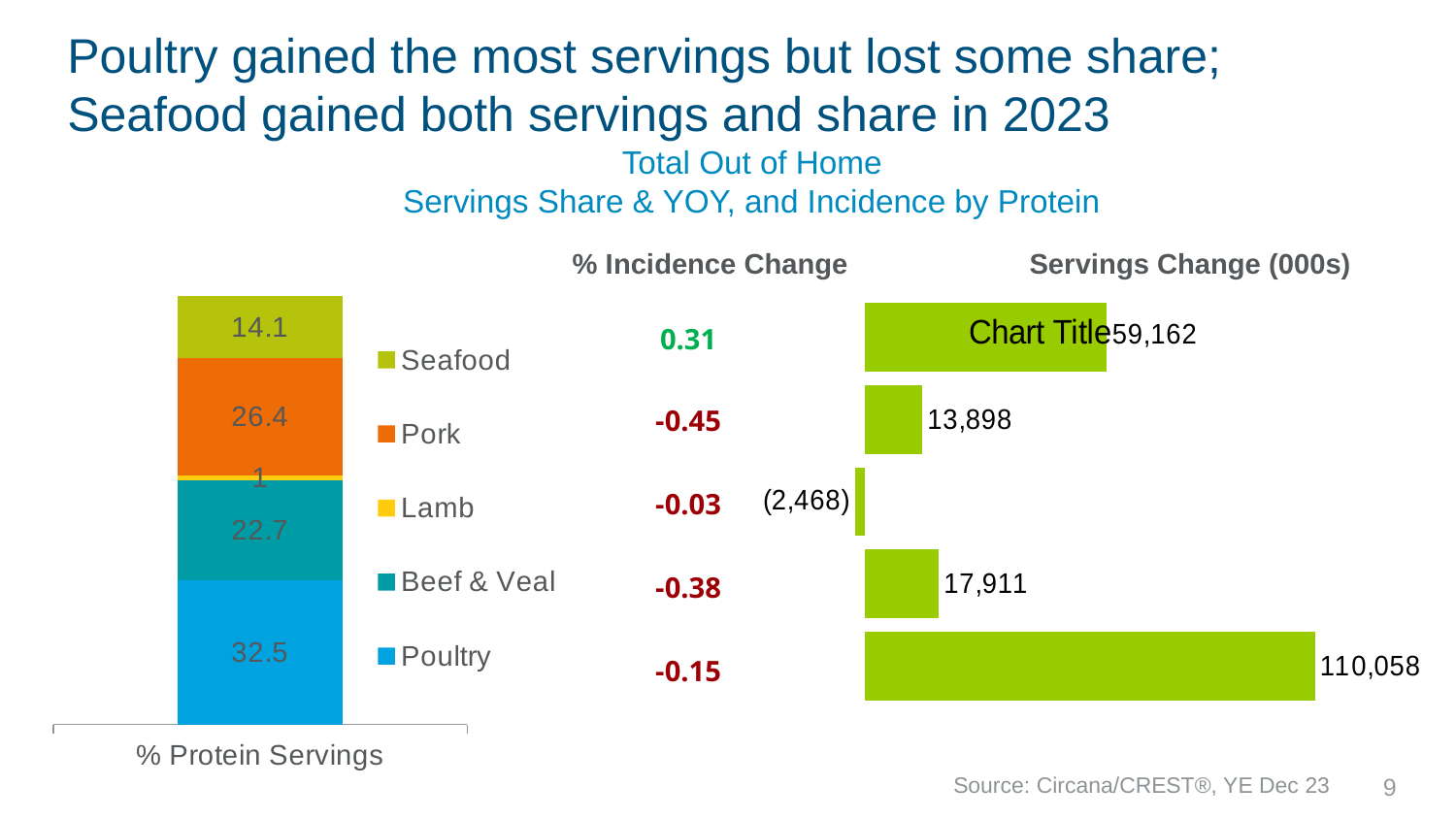
In the % Protein Servings stacked bar chart on the left, what is the value for Pork? 26.4 In the % Protein Servings stacked bar chart on the left, what is the value for Poultry? 32.5 In the Servings Change (000s) chart on the right, what is the value for Poultry (the bottom bar)? 110,058 In the % Protein Servings stacked bar chart on the left, which protein has the smallest share? Lamb In the Servings Change (000s) chart on the right, what is the value for Lamb (the middle bar)? (2,468) In the Servings Change (000s) chart on the right, how many bars are plotted? 5 In the % Protein Servings stacked bar chart on the left, what is the difference between the Pork and Seafood values? 12.3 In the % Protein Servings stacked bar chart on the left, which protein has the largest share? Poultry In the Servings Change (000s) chart on the right, which is larger: the Beef & Veal bar or the Pork bar? Beef & Veal In the Servings Change (000s) chart on the right, which bar is the longest? Poultry (110,058) What type of chart is the Servings Change (000s) chart on the right? Bar chart In the % Protein Servings stacked bar chart on the left, how many series does the legend list? 5